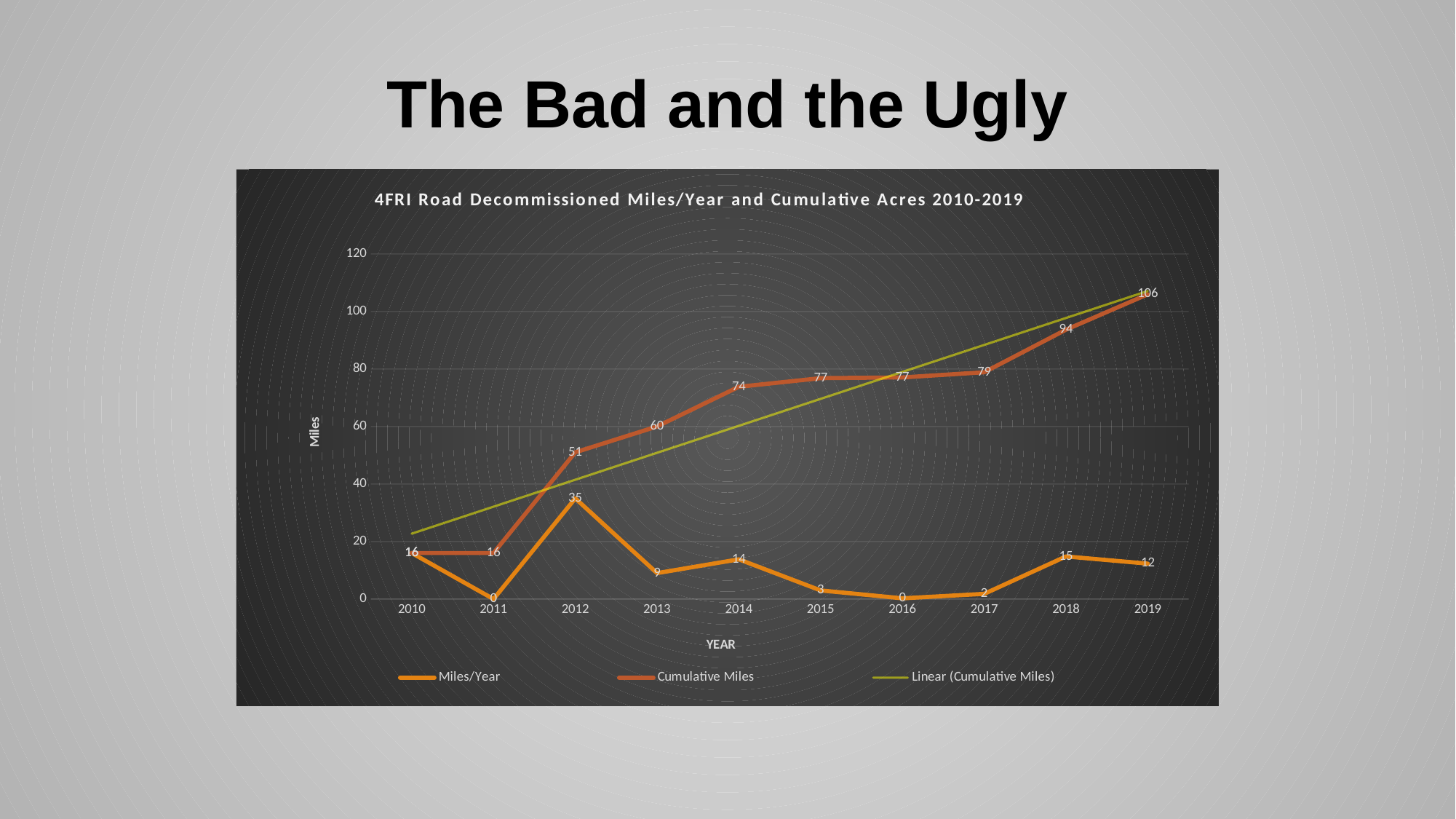
What is the Cumulative Miles value for 2019? 106 Which year has the lowest Cumulative Miles value? 2010 and 2011 (both 16) Which is larger, the Miles/Year value for 2018 or for 2013? 2018 What kind of chart is shown on the slide? line chart Is the Cumulative Miles value for 2012 greater or less than 40? greater How many years are shown on the x axis? 10 What is the Miles/Year value for 2012? 35 Which year has the highest Miles/Year value? 2012 Does the Cumulative Miles series rise or fall from 2010 to 2019? rise How many series does the legend list? 3 What is the difference between the Cumulative Miles values for 2018 and 2017? 15 What is the Cumulative Miles value for 2014? 74